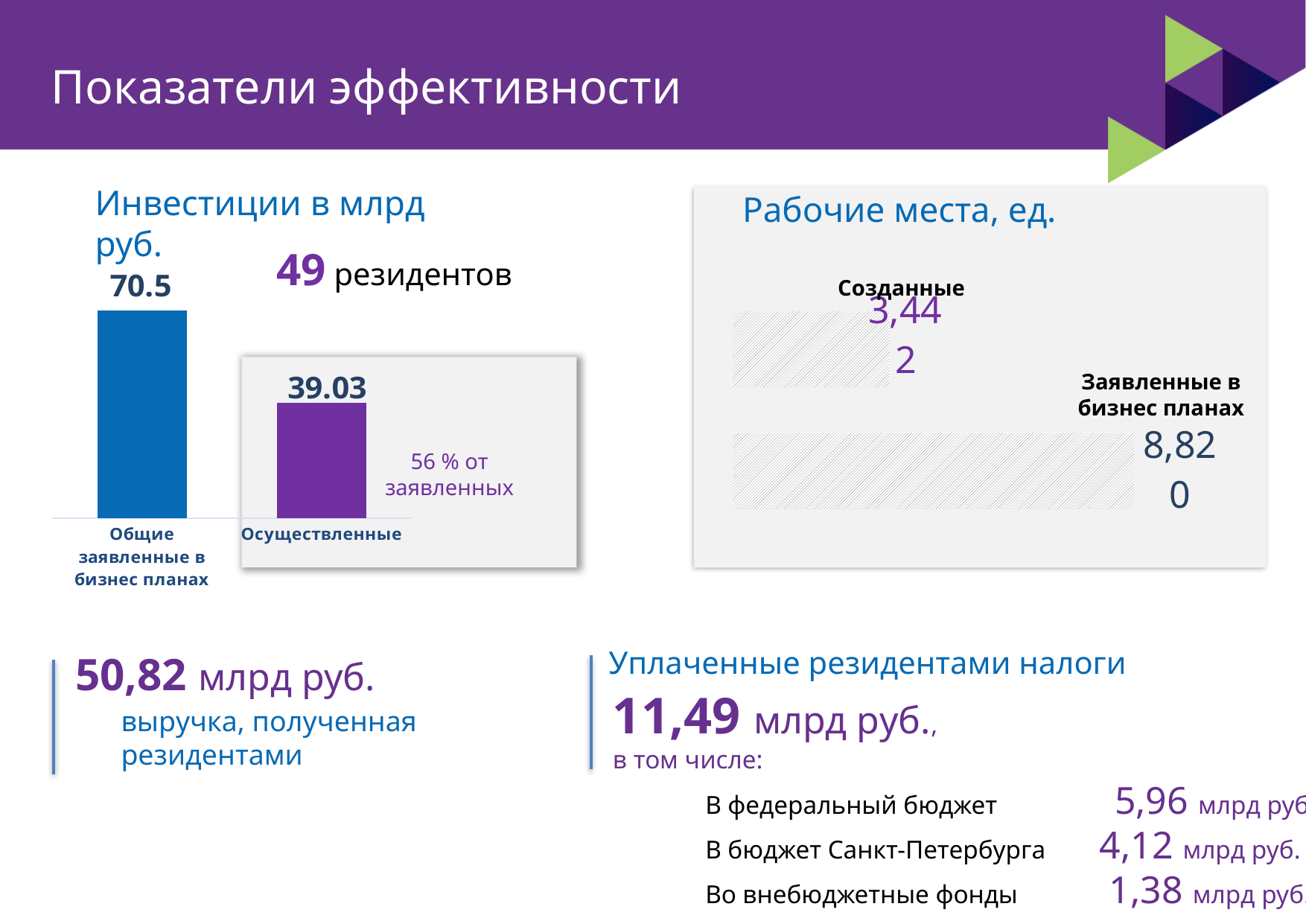
In the chart 'Рабочие места, ед.', which category has the lowest value? Созданные In the chart 'Инвестиции в млрд руб.', what is the difference between 'Общие заявленные в бизнес планах' and 'Осуществленные'? 31.47 In the chart 'Инвестиции в млрд руб.', what is the value for 'Общие заявленные в бизнес планах'? 70.5 In the chart 'Инвестиции в млрд руб.', what is the value for 'Осуществленные'? 39.03 What kind of chart is 'Инвестиции в млрд руб.'? bar chart How many bars are shown in the chart 'Инвестиции в млрд руб.'? 2 What is the title of the chart on the right side of the slide? Рабочие места, ед. In the chart 'Инвестиции в млрд руб.', which category has the lowest value? Осуществленные In the chart 'Рабочие места, ед.', which category has the higher value: 'Созданные' or 'Заявленные в бизнес планах'? Заявленные в бизнес планах How many categories are shown in the chart 'Рабочие места, ед.'? 2 In the chart 'Инвестиции в млрд руб.', which is larger: 'Общие заявленные в бизнес планах' or 'Осуществленные'? Общие заявленные в бизнес планах In the chart 'Инвестиции в млрд руб.', which category has the highest value? Общие заявленные в бизнес планах